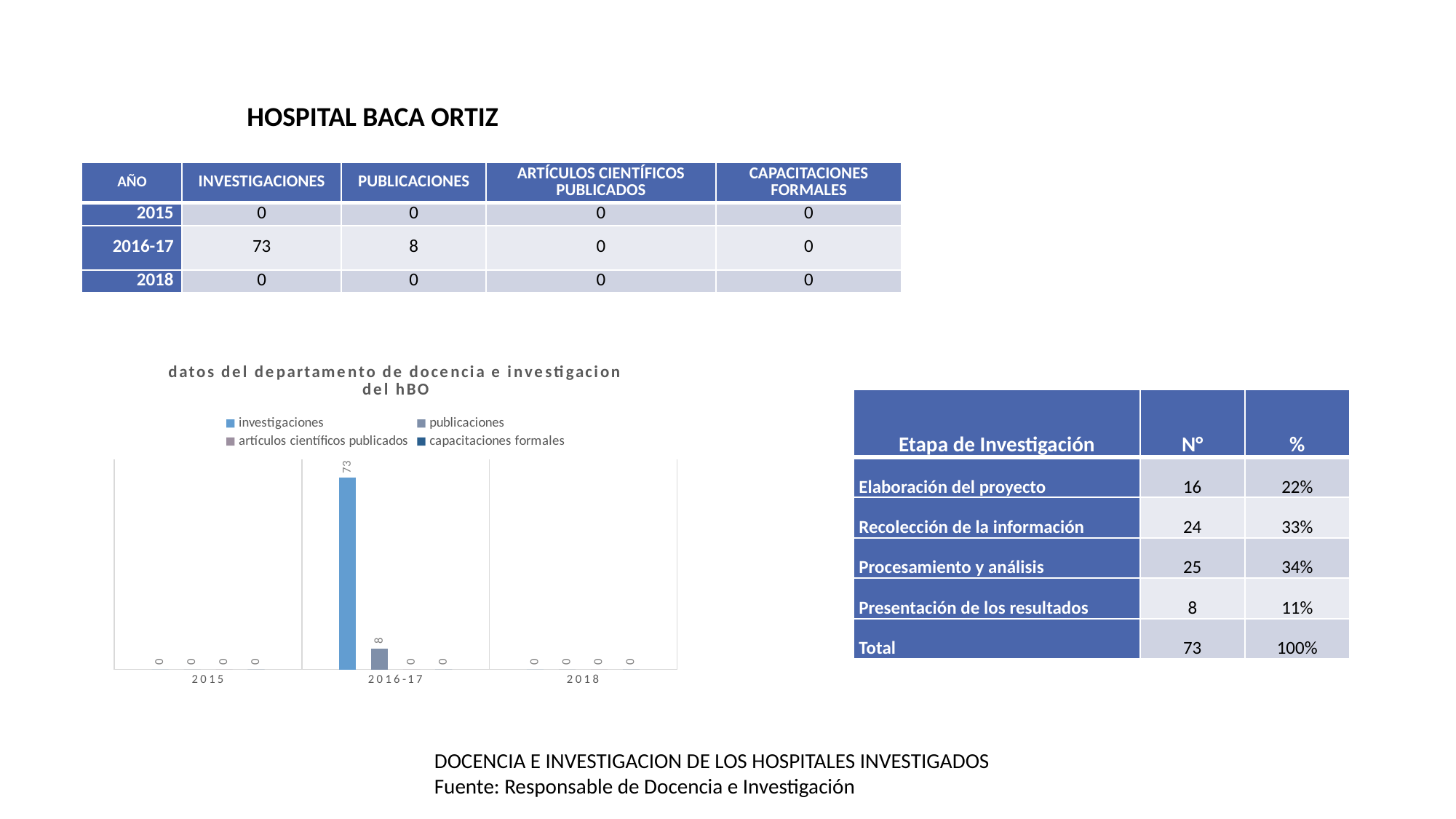
How many series does the chart legend list? 4 Which year has the highest value for investigaciones? 2016-17 What is the value for publicaciones in 2016-17? 8 What is the difference between investigaciones and publicaciones in 2016-17? 65 In 2016-17, which is larger: investigaciones or publicaciones? investigaciones What is the value for investigaciones in 2015? 0 What is the title of the chart? datos del departamento de docencia e investigacion del hBO What is the value for investigaciones in 2016-17? 73 What is the value for capacitaciones formales in 2018? 0 What is the total of all four series in 2016-17? 81 What type of chart is shown on the slide? bar chart How many year categories are shown on the x axis of the chart? 3